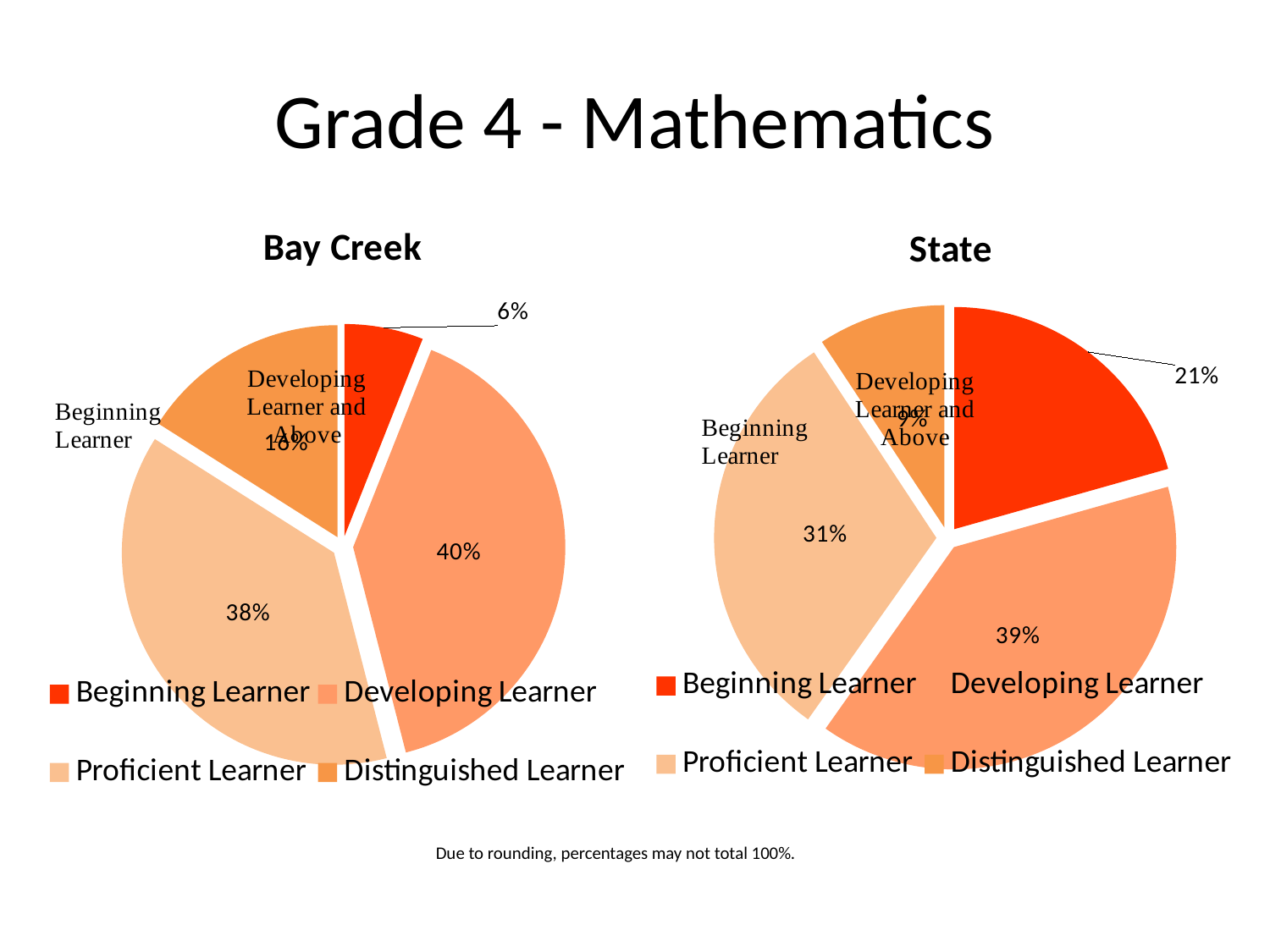
Which chart shows a larger share for Beginning Learner, Bay Creek or State? State In the Bay Creek pie chart, what percentage is shown for Proficient Learner? 38% What type of chart is used for the Bay Creek and State data? Pie chart In the State pie chart, what is the difference between Developing Learner and Proficient Learner? 8 percentage points In the Bay Creek pie chart, what percentage is shown for Developing Learner? 40% In the State pie chart, what percentage is shown for Beginning Learner? 21% In the Bay Creek pie chart, which category has the largest slice? Developing Learner In the State pie chart, what percentage is shown for Proficient Learner? 31% In the Bay Creek pie chart, how many percentage points larger is Developing Learner than Proficient Learner? 2 percentage points In the State pie chart, which category has the smallest slice? Distinguished Learner In the State pie chart, what percentage is shown for Developing Learner? 39% In the Bay Creek pie chart, what percentage is shown for Beginning Learner? 6%